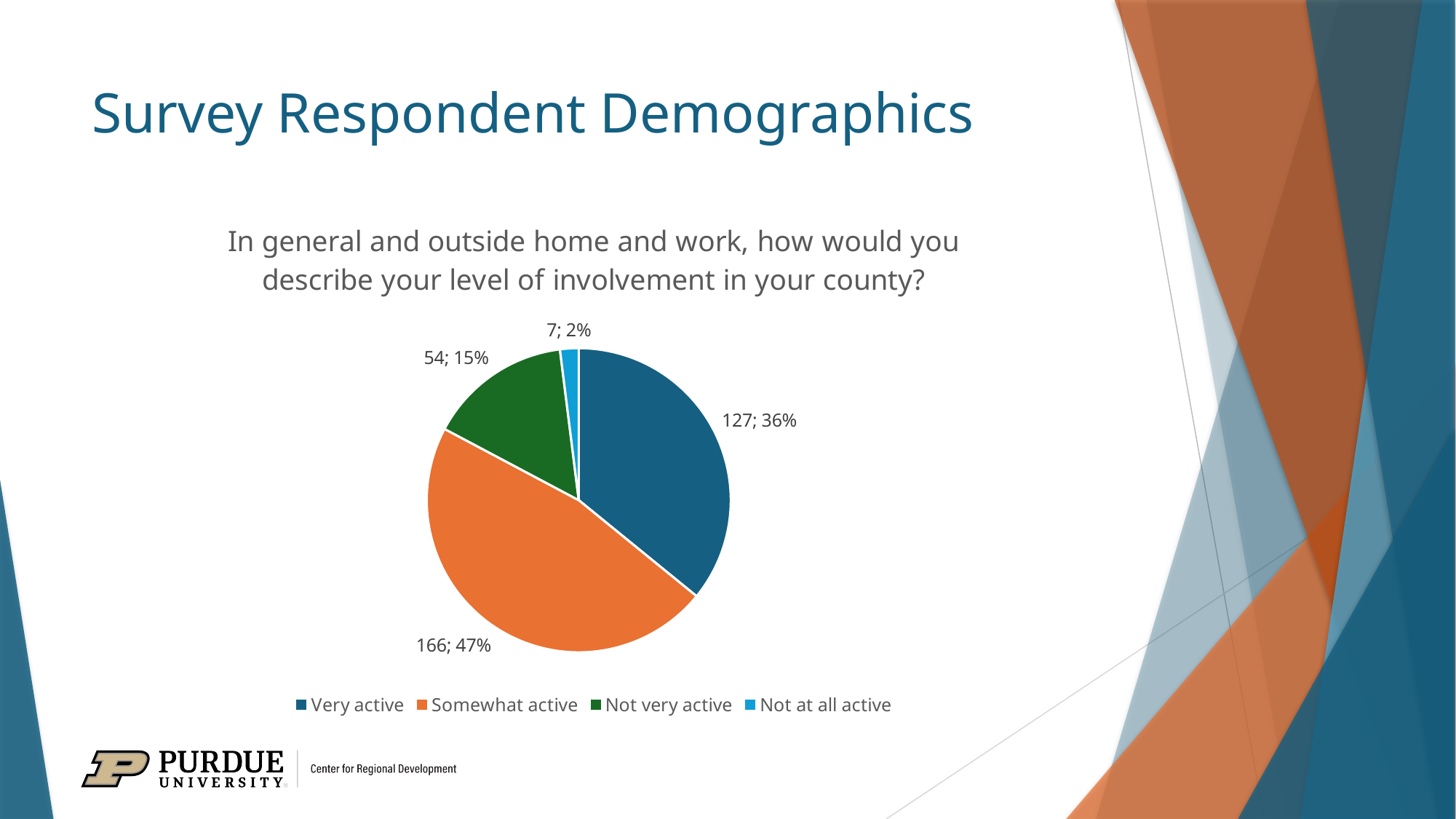
How many respondents answered "Not very active"? 54 What colour is the "Not very active" slice in the pie chart? green Which response category has the smallest slice of the pie? Not at all active What percentage of respondents answered "Somewhat active"? 47% Which has more respondents, "Not very active" or "Not at all active"? Not very active What percentage of respondents answered "Not at all active"? 2% What is the difference in respondent count between "Somewhat active" and "Very active"? 39 What kind of chart is shown on the slide? pie chart What share of the pie does the "Very active" slice represent? 36% How many respondents answered "Very active"? 127 Which response category has the largest slice of the pie? Somewhat active How many categories does the pie chart show? 4